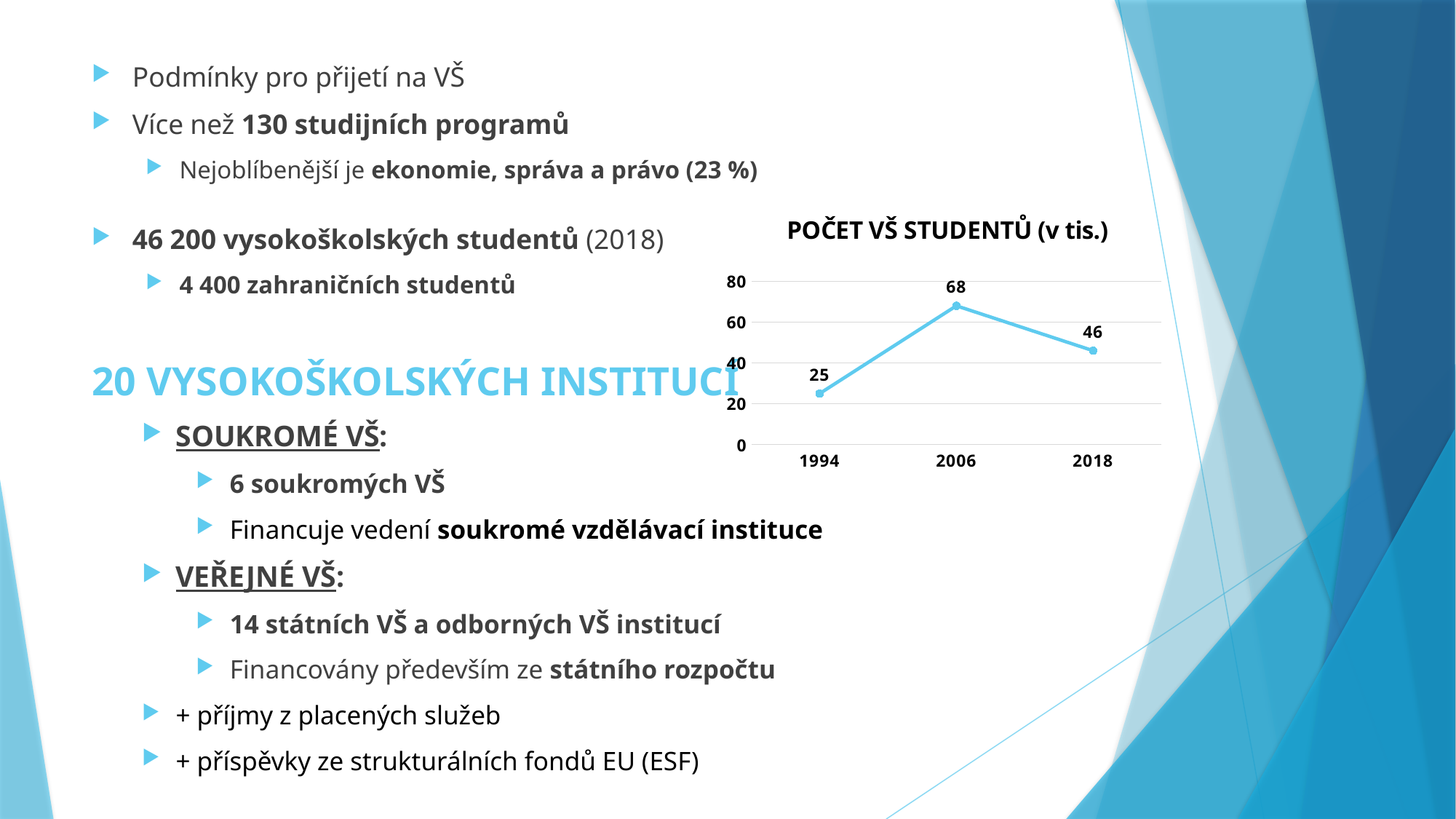
What kind of chart is shown on the slide? line chart What is the value for 1994 in the chart? 25 What is the difference between the values for 2006 and 2018? 22 Which is larger, the value for 2018 or the value for 1994? 2018 Which year has the highest value in the chart? 2006 Is the value for 2018 greater or less than 40? greater What is the value for 2018 in the chart? 46 How many data points are plotted in the chart? 3 What is the difference between the values for 2006 and 1994? 43 What is the value for 2006 in the chart? 68 Which year has the lowest value in the chart? 1994 What is the title of the chart? POČET VŠ STUDENTŮ (v tis.)